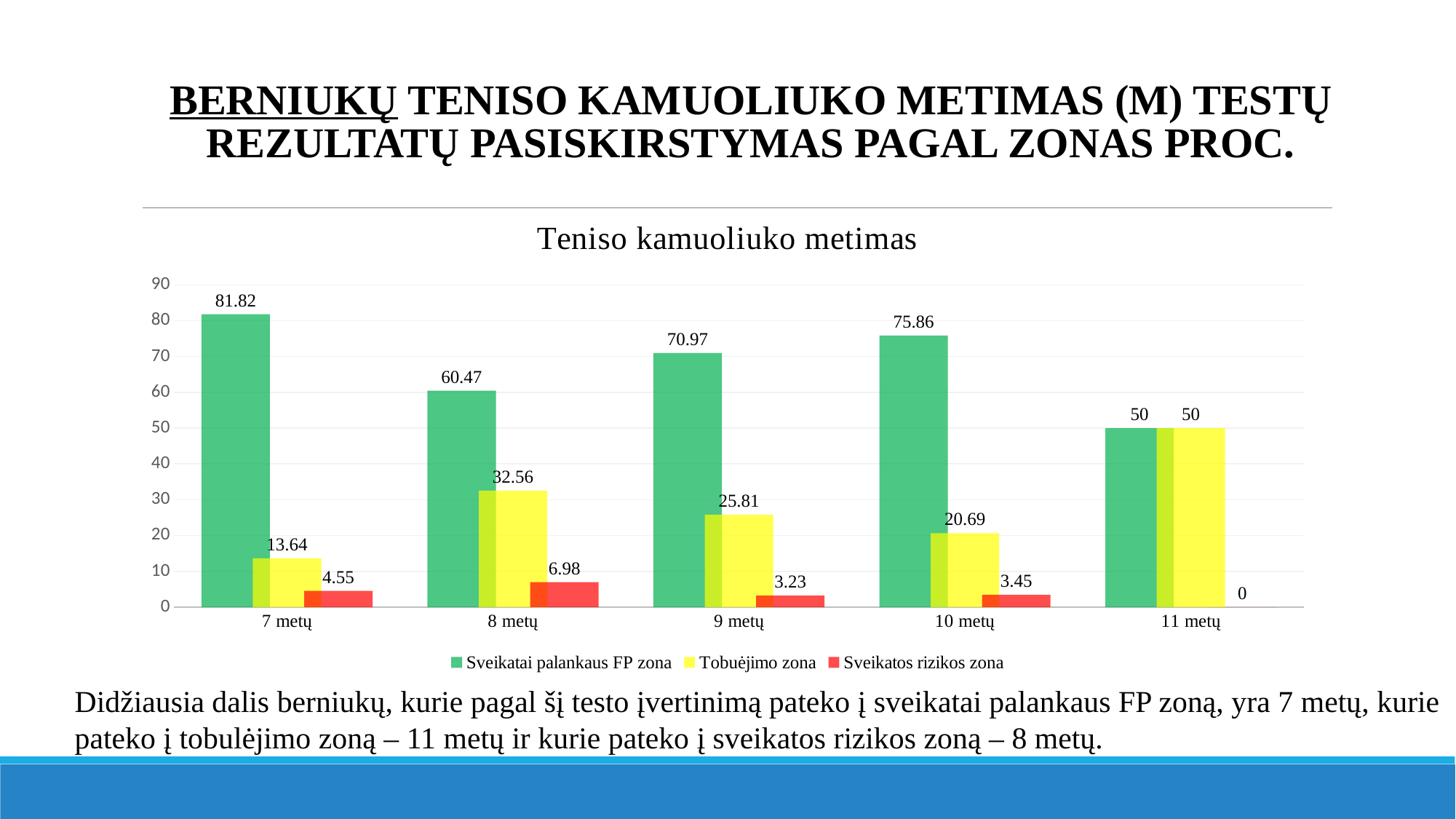
Which age group has the highest value for 'Sveikatai palankaus FP zona'? 7 metų What is the title of the chart? Teniso kamuoliuko metimas What is the value for 'Tobuėjimo zona' for 8 metų? 32.56 How many series does the legend list? 3 How many age groups are shown on the x axis? 5 Which age group has the lowest value for 'Tobuėjimo zona'? 7 metų What is the value for 'Sveikatos rizikos zona' for 11 metų? 0 What kind of chart is shown on the slide? Bar chart What is the value for 'Sveikatos rizikos zona' for 9 metų? 3.23 What is the value for 'Sveikatai palankaus FP zona' for 7 metų? 81.82 Which is larger: the 'Sveikatos rizikos zona' value for 8 metų or for 10 metų? 8 metų What is the difference between the 'Sveikatai palankaus FP zona' values for 7 metų and 8 metų? 21.35